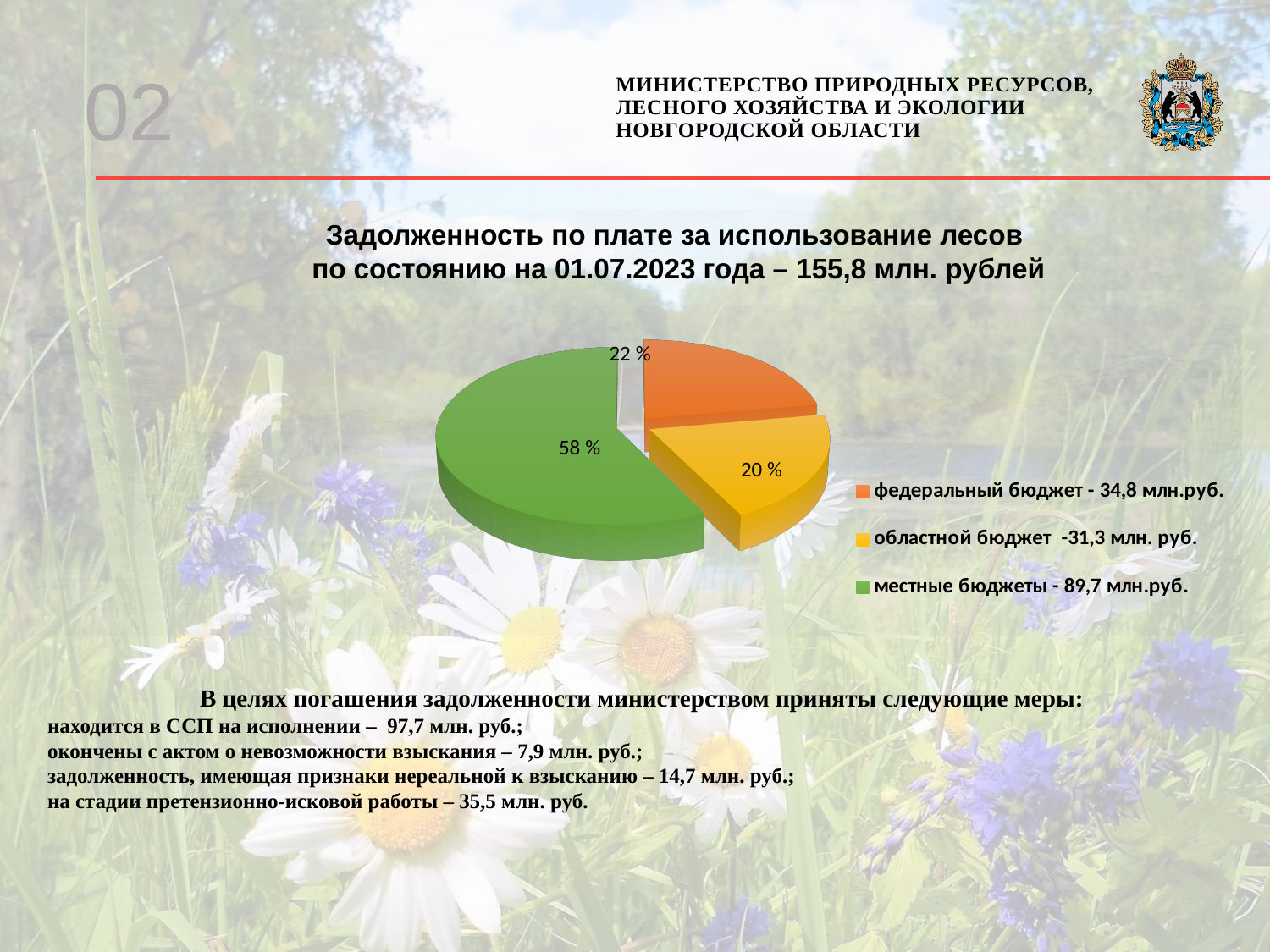
Which colour represents "областной бюджет" in the pie chart? yellow What share of the pie does "областной бюджет" account for? 20 % Which category has the largest slice of the pie? местные бюджеты According to the legend, what is the debt amount for "федеральный бюджет"? 34,8 млн.руб. What share of the pie does "федеральный бюджет" account for? 22 % What kind of chart is shown on the slide? pie chart What share of the pie does "местные бюджеты" account for? 58 % How many slices does the pie chart have? 3 Which category has the smallest slice of the pie? областной бюджет How many entries does the legend of the pie chart list? 3 According to the legend, what is the debt amount for "местные бюджеты"? 89,7 млн.руб. By how many percentage points does the share of "местные бюджеты" exceed the share of "федеральный бюджет"? 36